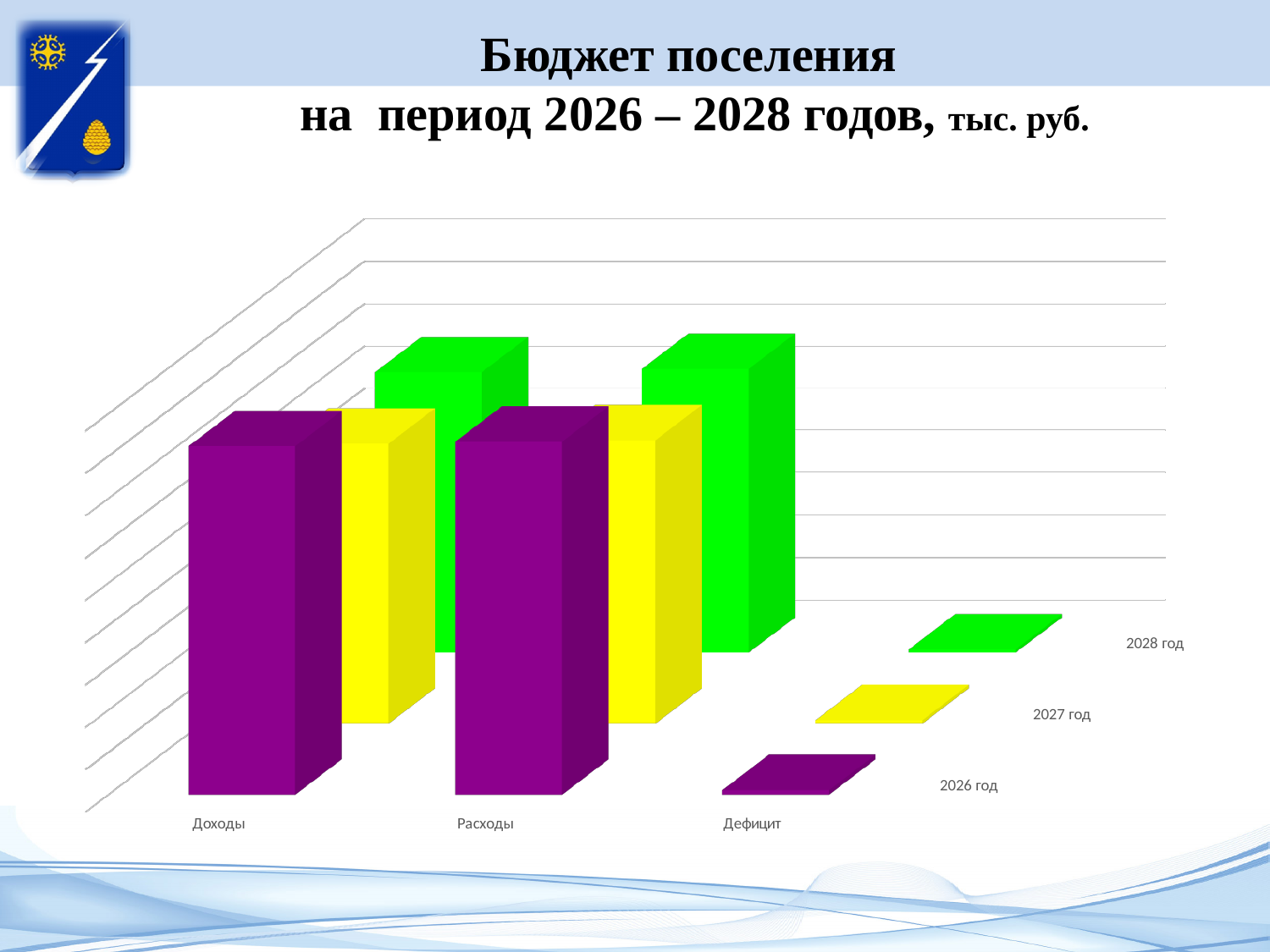
Which series does the yellow bar represent? 2027 год For 2028 год, which is larger: Расходы or Дефицит? Расходы How many categories are shown on the x axis of the chart? 3 Which series is shown in purple in the chart? 2026 год For 2027 год, which is larger: Дефицит or Доходы? Доходы For 2026 год, which is larger: Доходы or Дефицит? Доходы What kind of chart is shown on the slide? bar chart What are the three categories listed along the x axis of the chart? Доходы, Расходы, Дефицит Which series is shown in green in the chart? 2028 год Which category has the lowest values in the chart? Дефицит